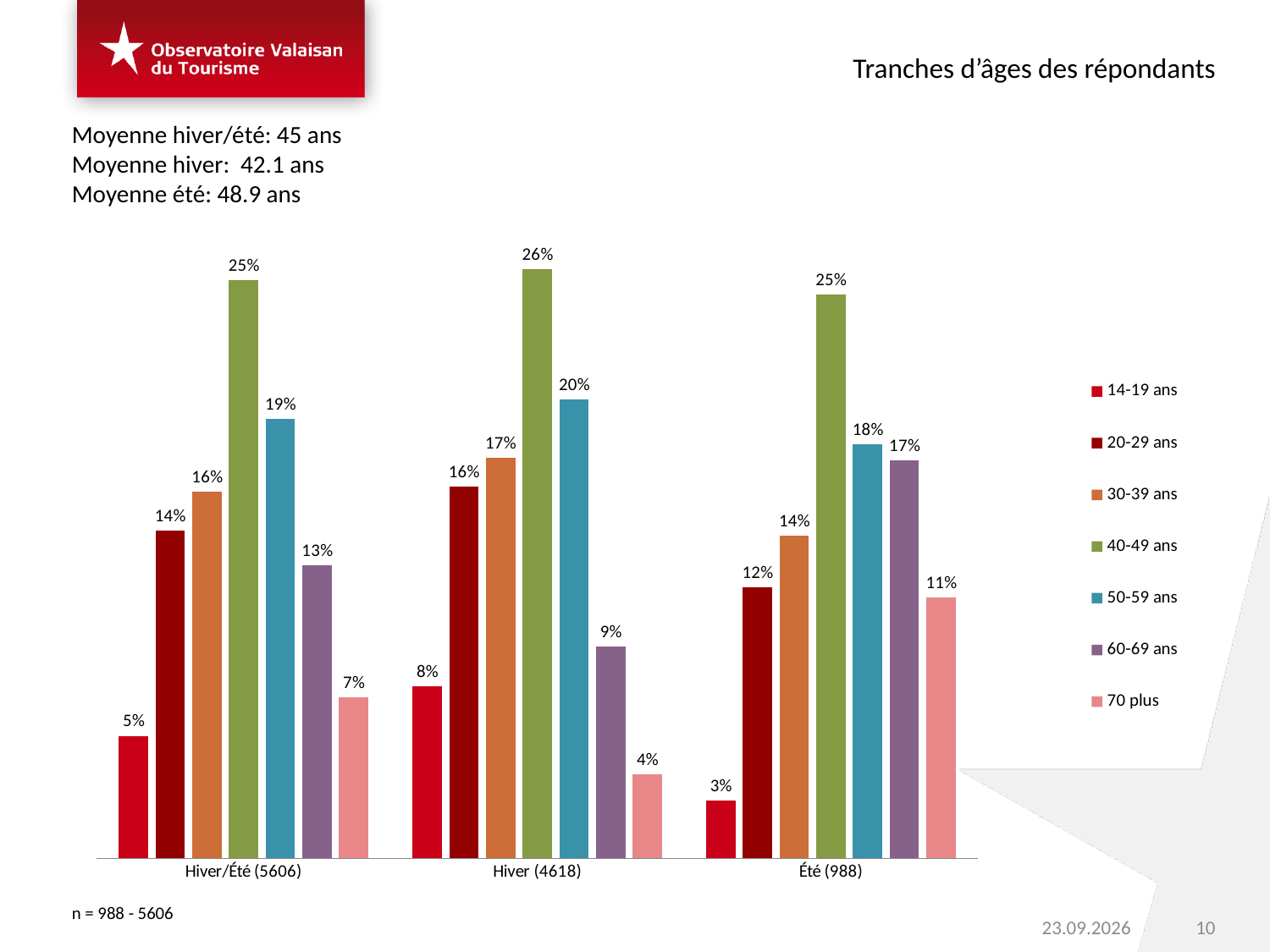
What is the value for 40-49 ans in the Hiver (4618) group? 26% What is the value for 14-19 ans in the Été (988) group? 3% What is the value for 70 plus in the Hiver/Été (5606) group? 7% How many series does the legend list? 7 Which age group has the highest value in the Hiver/Été (5606) group? 40-49 ans How many groups are shown on the x axis? 3 What kind of chart is shown on the slide? Bar chart Which age group has the lowest value in the Hiver (4618) group? 70 plus What is the value for 60-69 ans in the Été (988) group? 17% What is the difference between the 50-59 ans values for Hiver (4618) and Été (988)? 2% Which is larger: the 70 plus value for Été (988) or for Hiver (4618)? Été (988) What is the title of the chart? Tranches d'âges des répondants